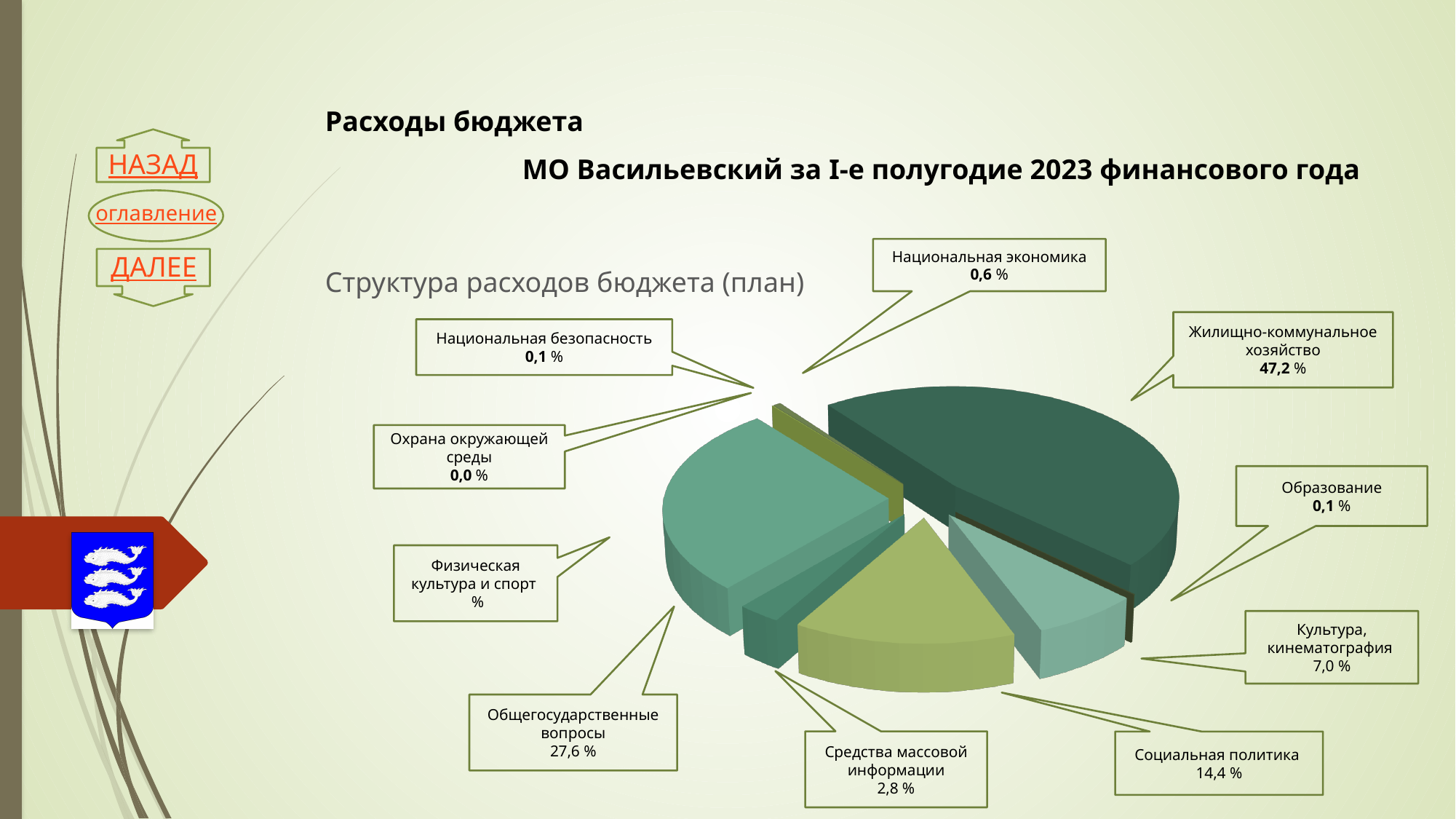
What is the title of the chart? Структура расходов бюджета (план) What is the value for Общегосударственные вопросы? 27,6 % What is the value for Национальная экономика? 0,6 % Which is larger, the share of Социальная политика or the share of Культура, кинематография? Социальная политика What kind of chart is shown on the slide? pie chart What is the value for Социальная политика? 14,4 % What is the value for Средства массовой информации? 2,8 % What is the value for Культура, кинематография? 7,0 % What is the difference between the shares of Жилищно-коммунальное хозяйство and Общегосударственные вопросы? 19,6 % What share of the pie does Жилищно-коммунальное хозяйство have? 47,2 % Which category has the largest share of the pie? Жилищно-коммунальное хозяйство